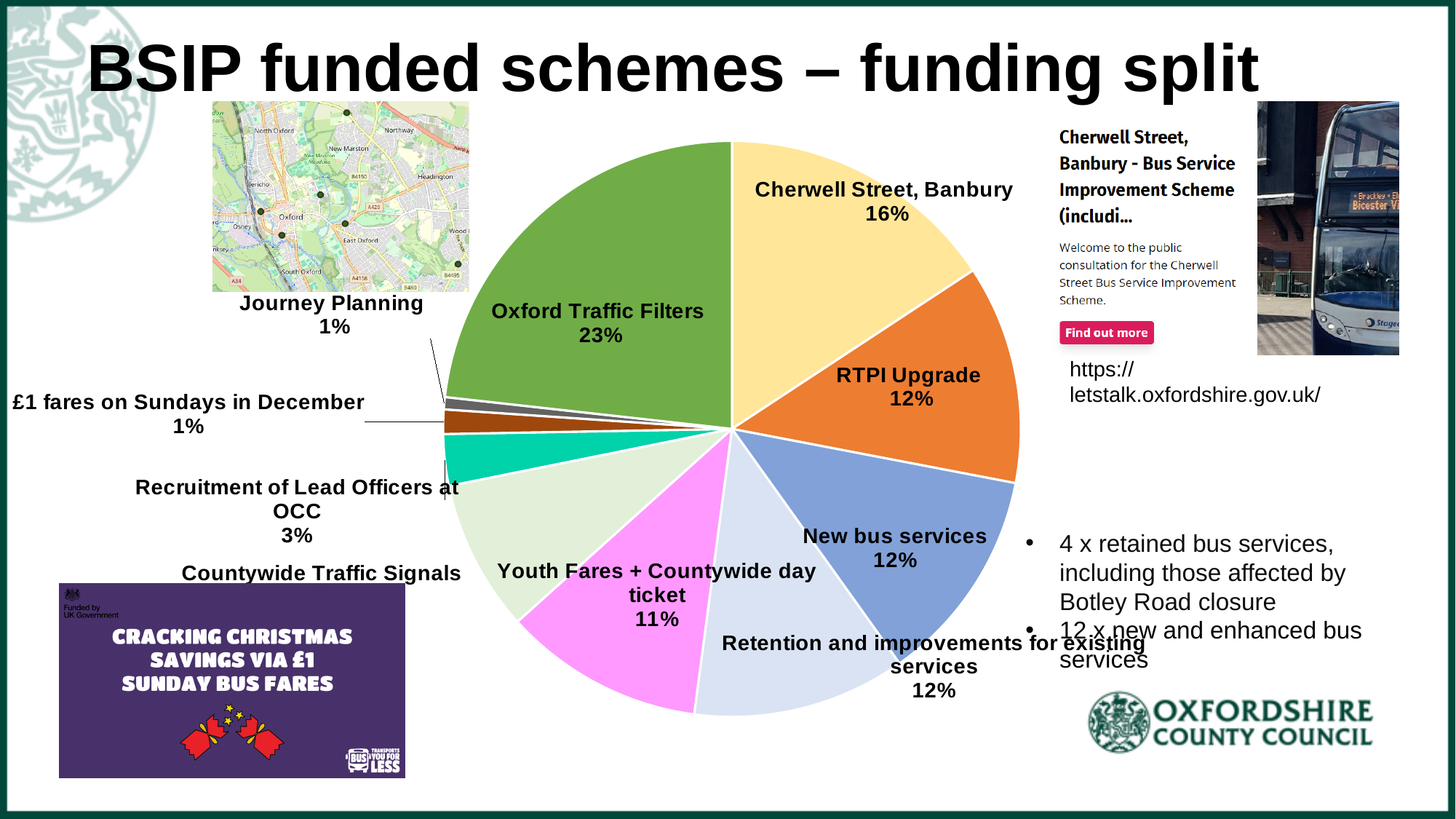
What share of the funding goes to Oxford Traffic Filters? 23% What share of the funding goes to Youth Fares + Countywide day ticket? 11% What is the title of the slide containing the pie chart? BSIP funded schemes – funding split What percentage is shown for Recruitment of Lead Officers at OCC? 3% What percentage is shown for Journey Planning? 1% Which scheme has the largest share of the funding? Oxford Traffic Filters What kind of chart is shown on the slide? pie chart What percentage is shown for Cherwell Street, Banbury? 16% Which has the larger share: Cherwell Street, Banbury or RTPI Upgrade? Cherwell Street, Banbury How many schemes (slices) are shown in the pie chart? 10 What percentage is shown for RTPI Upgrade? 12% How many percentage points larger is the Oxford Traffic Filters share than the Cherwell Street, Banbury share? 7